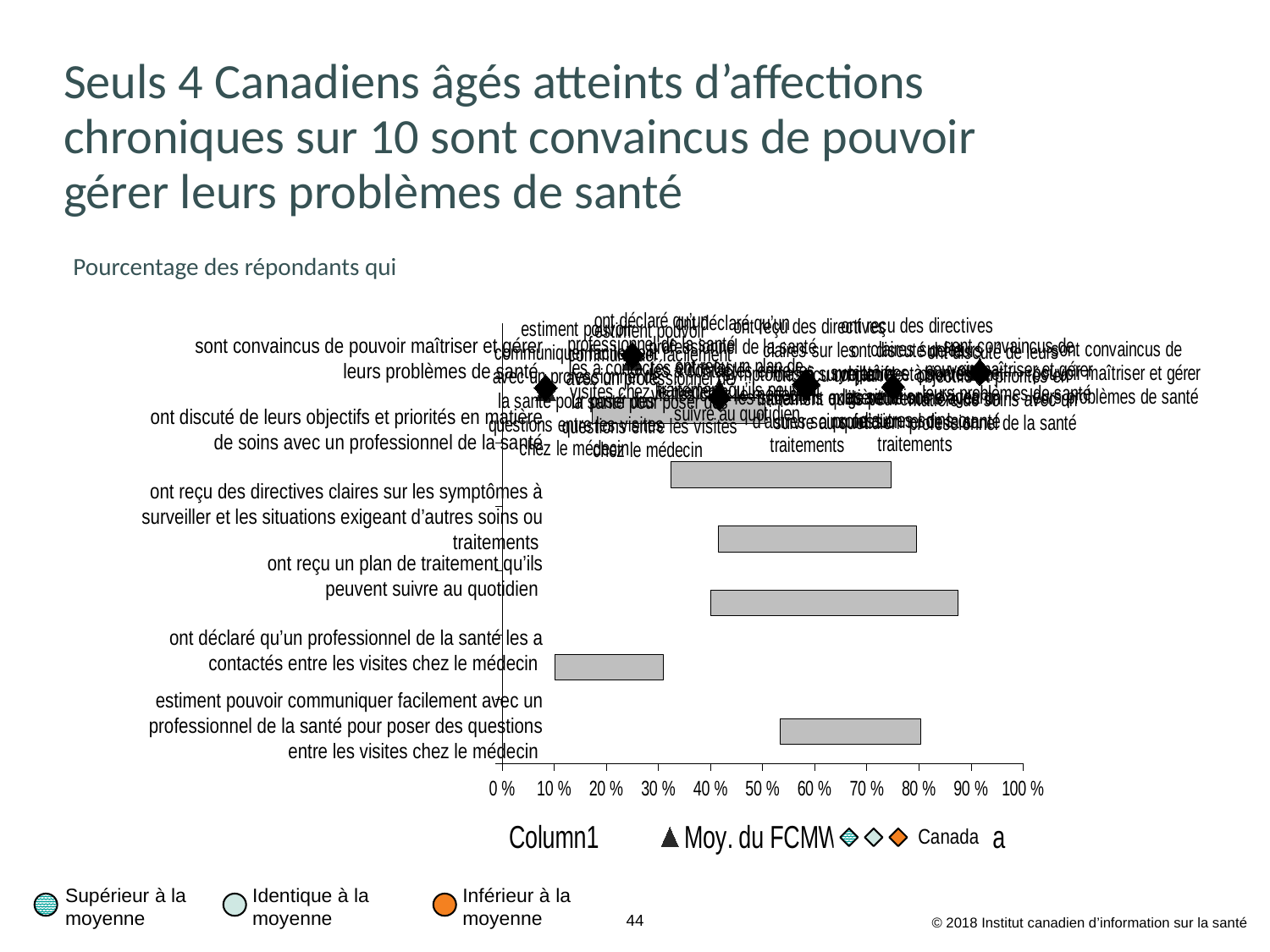
Which category's bar extends furthest to the right (highest value) on the chart? ont reçu un plan de traitement qu'ils peuvent suivre au quotidien What is the subtitle printed above the chart? Pourcentage des répondants qui How many categories (respondent statements) are listed on the vertical axis of the chart? 6 Which category's bar starts furthest to the left (lowest value) on the chart? ont déclaré qu'un professionnel de la santé les a contactés entre les visites chez le médecin Is the bar for 'estiment pouvoir communiquer facilement avec un professionnel de la santé pour poser des questions entre les visites chez le médecin' entirely greater or less than 50 %? greater What is the highest value shown on the horizontal axis of the chart? 100 % What kind of chart is shown on the slide? bar chart Is the bar for 'ont déclaré qu'un professionnel de la santé les a contactés entre les visites chez le médecin' entirely greater or less than 40 %? less Which bar reaches further right: 'ont reçu un plan de traitement qu'ils peuvent suivre au quotidien' or 'ont déclaré qu'un professionnel de la santé les a contactés entre les visites chez le médecin'? ont reçu un plan de traitement qu'ils peuvent suivre au quotidien